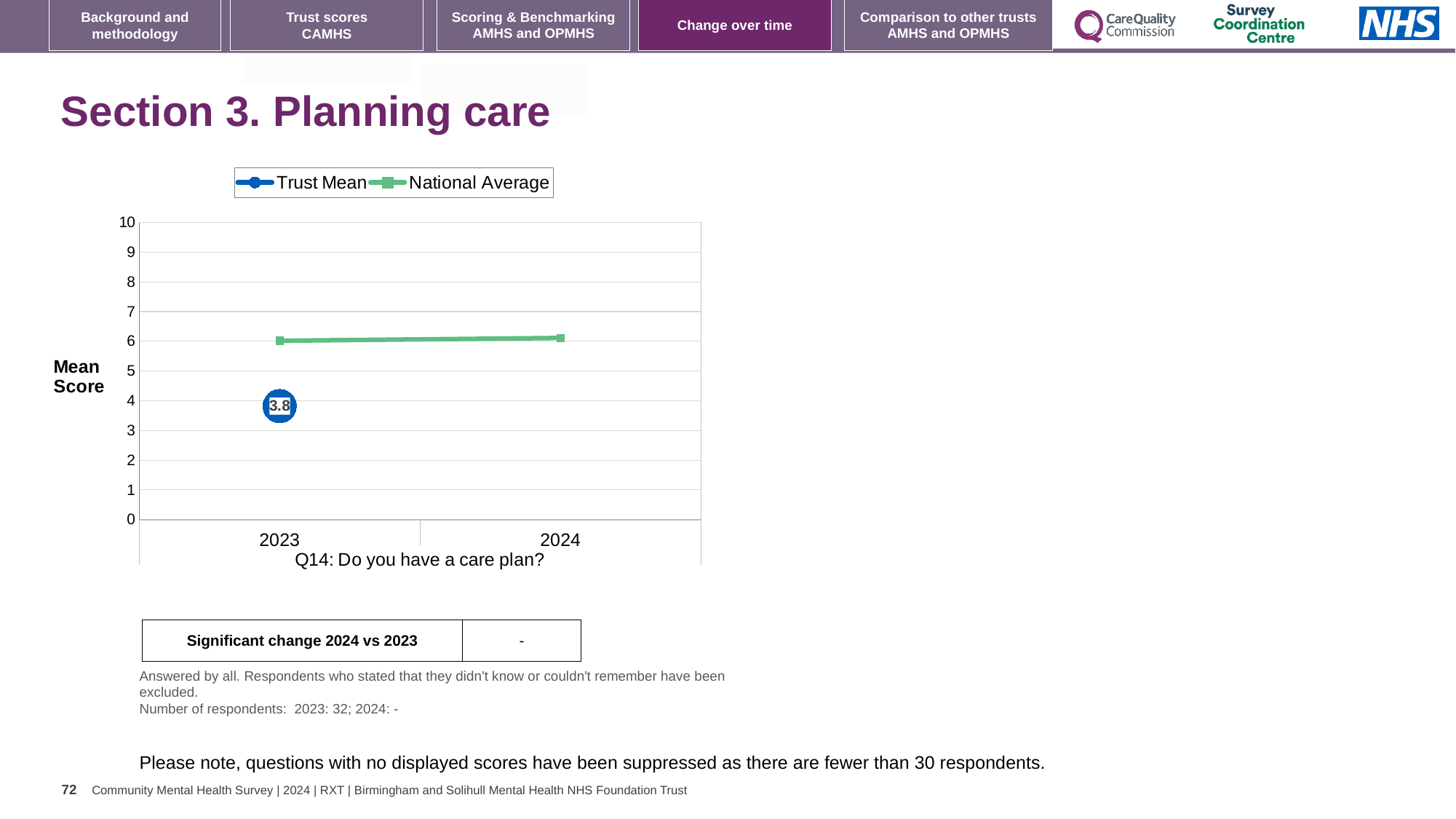
In 2023, which is larger: the Trust Mean or the National Average? National Average What is the label on the y axis? Mean Score Is the National Average value for 2024 greater or less than 7? less Is the National Average value for 2023 greater or less than 5? greater What kind of chart is shown on the slide? line chart Is the Trust Mean value for 2023 greater or less than 5? less How many series does the legend list? 2 What is the Trust Mean value for 2023? 3.8 How many years are shown on the x axis? 2 What are the two series named in the legend? Trust Mean and National Average